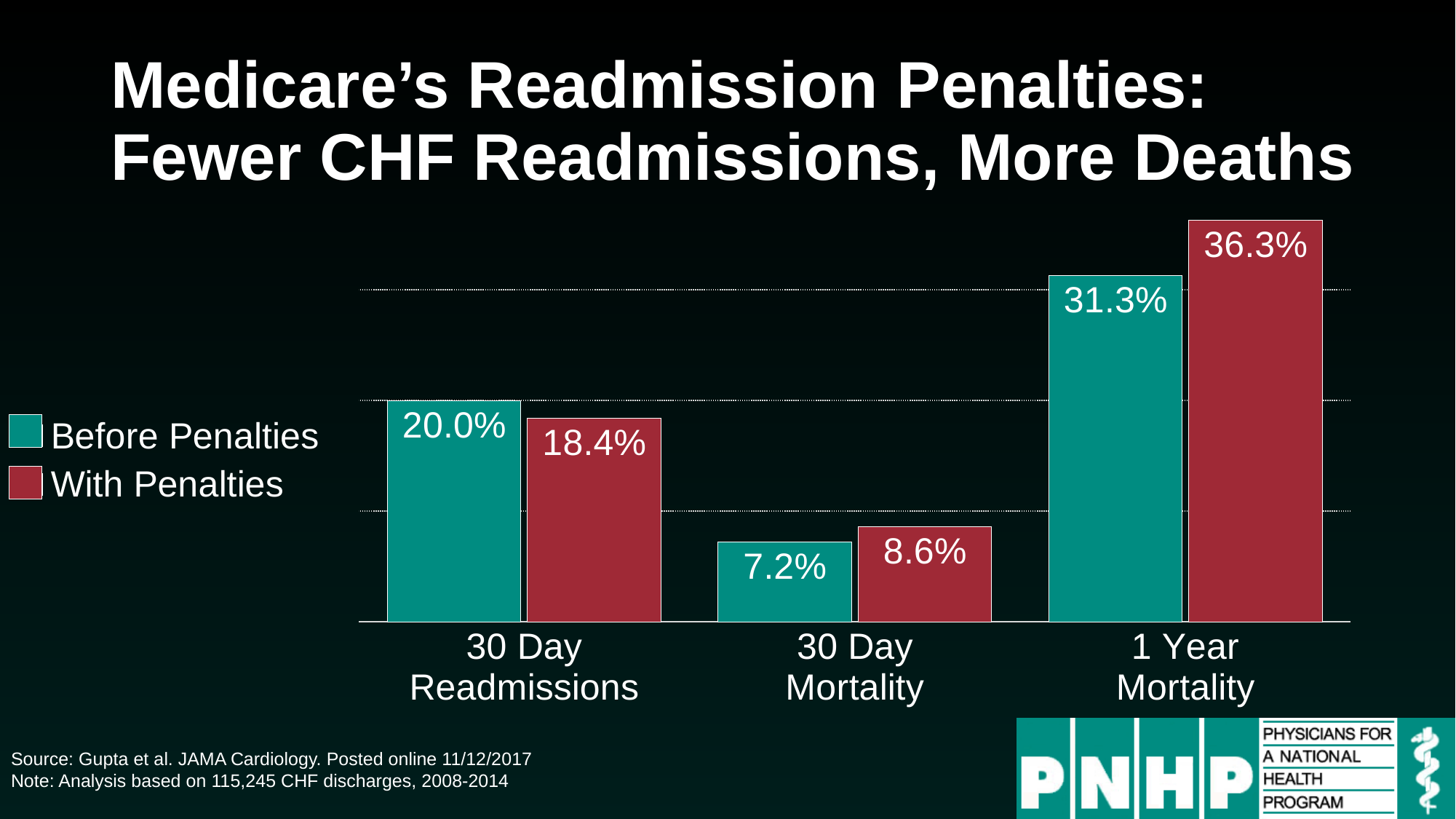
What is the 1 Year Mortality value for With Penalties? 36.3% How many series does the legend list? 2 How many categories are shown on the x axis? 3 What is the 30 Day Mortality value for Before Penalties? 7.2% What kind of chart is shown on the slide? Bar chart What is the difference between the Before Penalties and With Penalties values for 30 Day Readmissions? 1.6% What is the difference between the With Penalties and Before Penalties values for 1 Year Mortality? 5.0% Which category has the lowest value for Before Penalties? 30 Day Mortality What is the 30 Day Readmissions value for With Penalties? 18.4% Which category has the highest value for With Penalties? 1 Year Mortality For 30 Day Mortality, which is larger: Before Penalties or With Penalties? With Penalties What is the 30 Day Readmissions value for Before Penalties? 20.0%